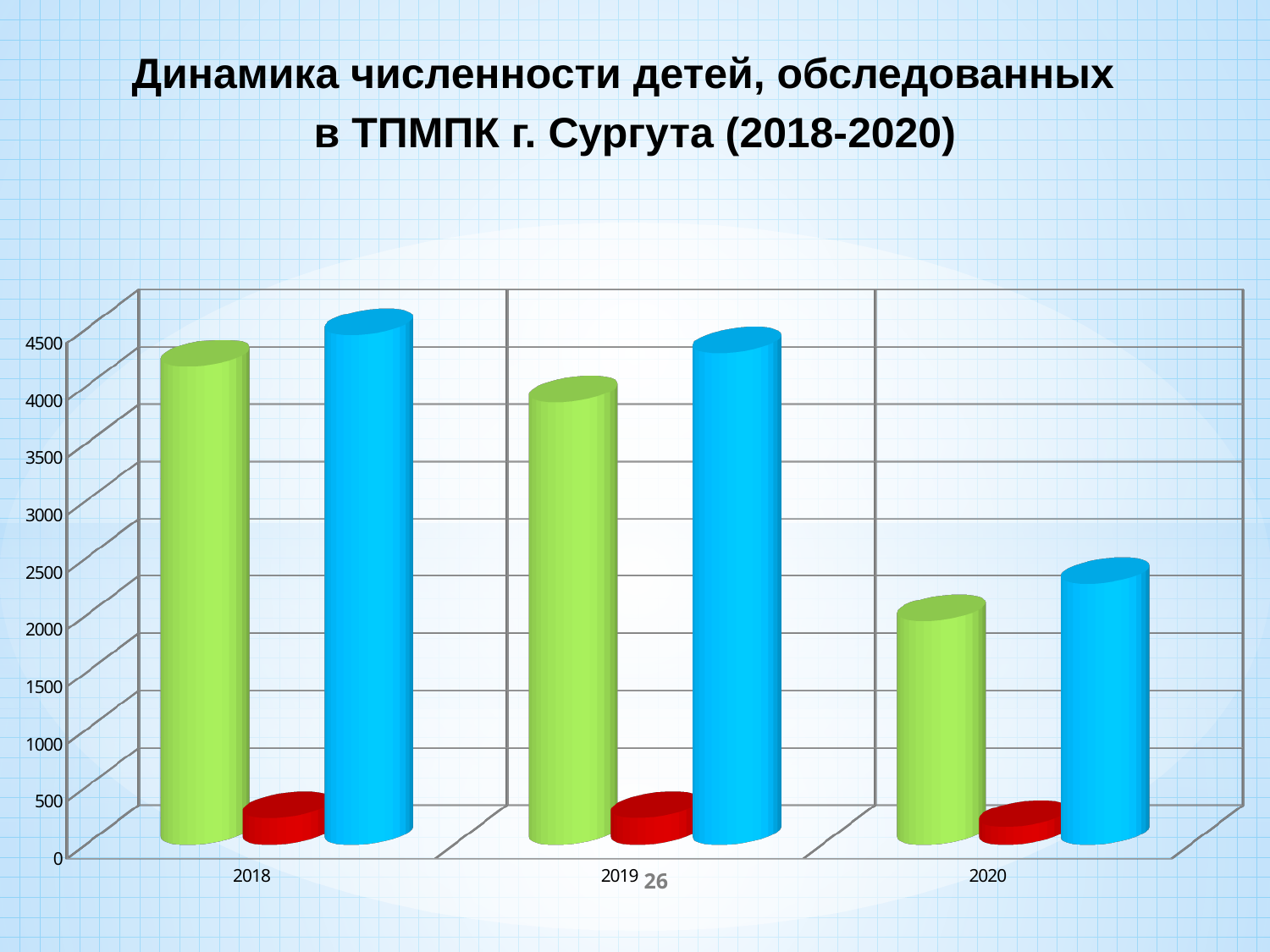
Which years are shown on the x axis? 2018, 2019, 2020 In which year is the green bar the lowest? 2020 Is the value of the blue bar for 2019 greater or less than 4000? greater Is the value of the green bar for 2020 greater or less than 1500? greater Is the value of the red bar for 2018 greater or less than 500? less What kind of chart is shown on the slide? bar chart In which year is the blue bar the highest? 2018 What is the title of the chart? Динамика численности детей, обследованных в ТПМПК г. Сургута (2018-2020) Do the blue bars rise or fall from 2018 to 2020? fall How many years (categories) are shown on the x axis? 3